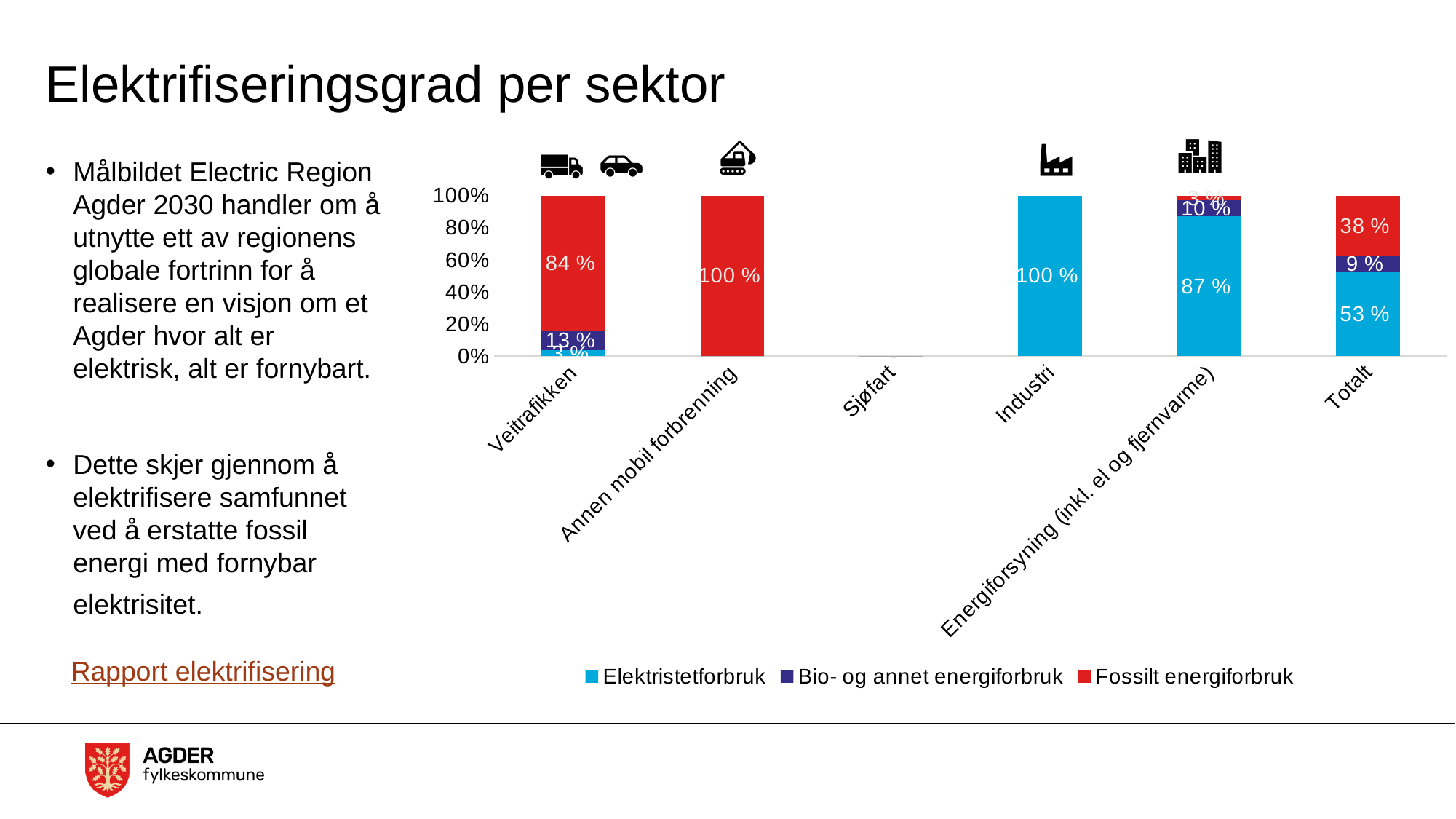
How many series does the chart legend list? 3 What type of chart is shown on the slide? Stacked bar chart Which is larger for Totalt: the Elektristetforbruk share or the Bio- og annet energiforbruk share? Elektristetforbruk What is the Fossilt energiforbruk share for Veitrafikken? 84 % Which category has the highest Elektristetforbruk share? Industri What is the Fossilt energiforbruk share for Annen mobil forbrenning? 100 % What is the difference between the Elektristetforbruk share and the Fossilt energiforbruk share for Totalt? 15 % How many categories are shown on the x axis of the chart? 6 What is the Fossilt energiforbruk share for Totalt? 38 % What is the Bio- og annet energiforbruk share for Veitrafikken? 13 % What is the Elektristetforbruk share for Energiforsyning (inkl. el og fjernvarme)? 87 % What is the Elektristetforbruk share for Industri? 100 %